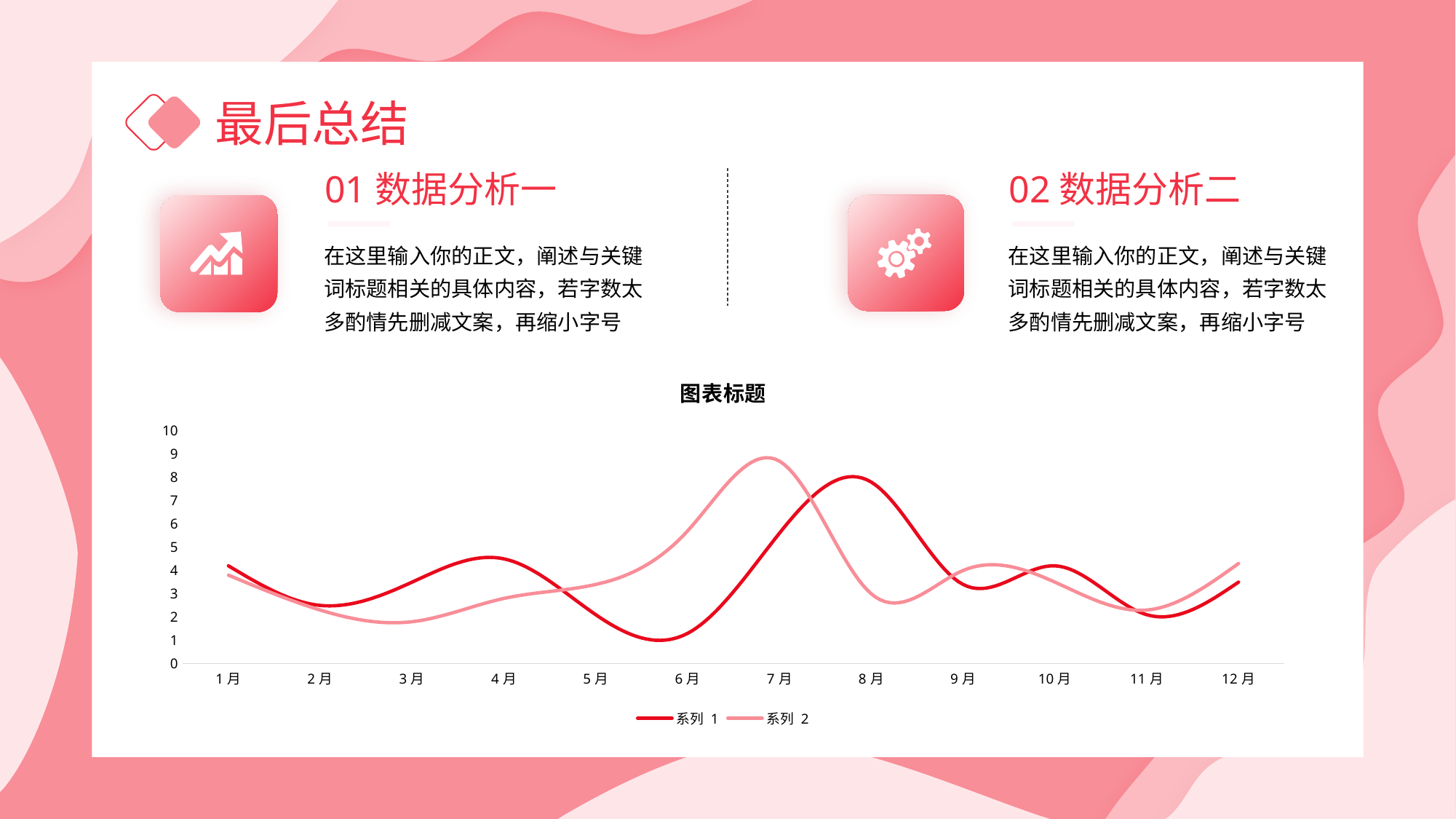
In which month does 系列 1 reach its highest value? 8月 Is the value for 系列 1 in 6月 greater or less than 2? less Is the value for 系列 1 in 8月 greater or less than 5? greater Which series has the larger value in 7月, 系列 1 or 系列 2? 系列 2 What kind of chart is shown on the slide? line chart What is the title of the chart? 图表标题 In which month does 系列 1 reach its lowest value? 6月 How many months are shown on the x axis of the chart? 12 How many series does the chart legend list? 2 In which month does 系列 2 reach its highest value? 7月 Does 系列 1 rise or fall from 6月 to 8月? rise What are the two legend entries of the chart? 系列 1, 系列 2